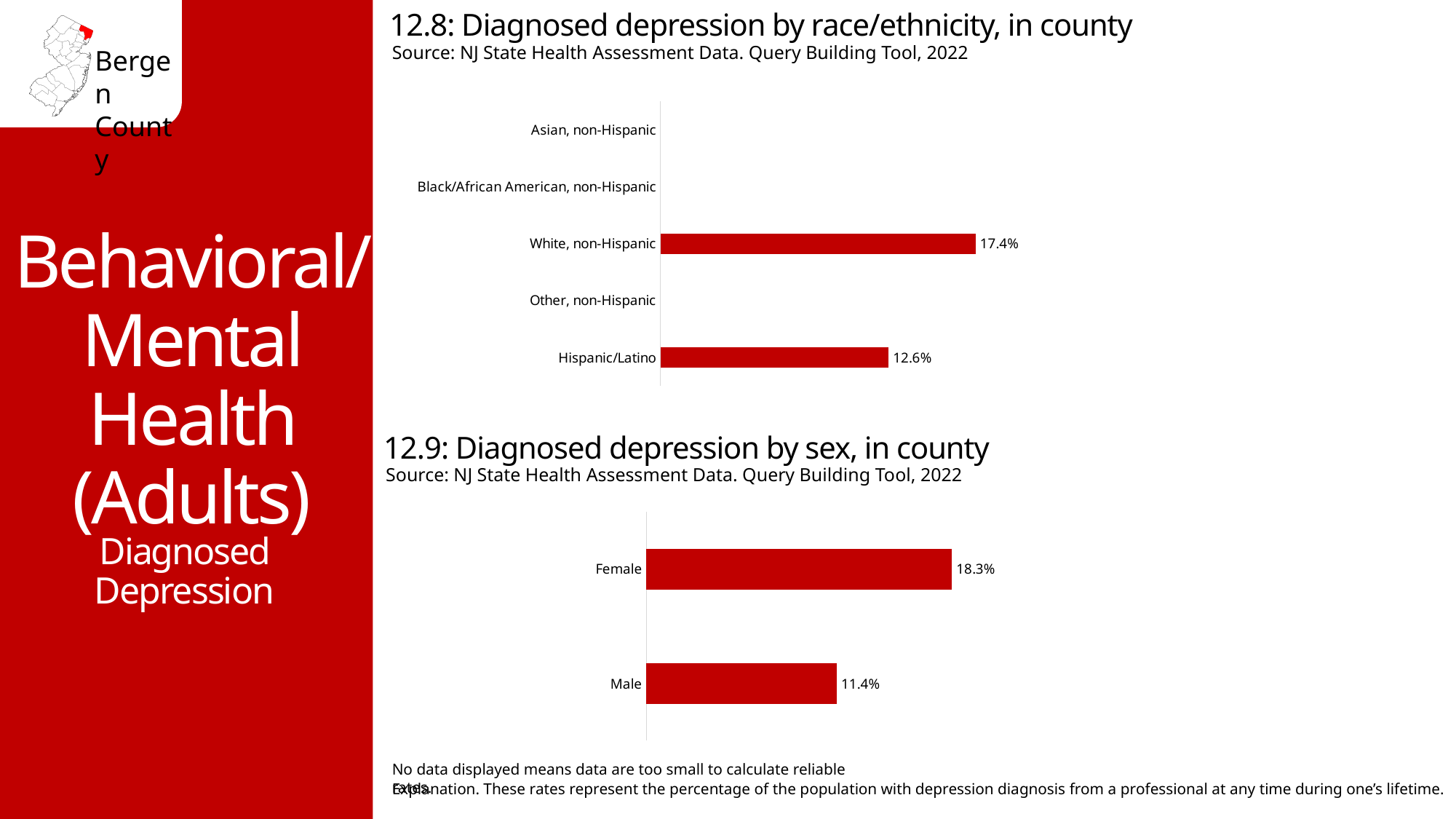
In the chart '12.9: Diagnosed depression by sex, in county', what is the value for Male? 11.4% In the chart '12.9: Diagnosed depression by sex, in county', is the value for Female larger than the value for Male? Yes In the chart '12.8: Diagnosed depression by race/ethnicity, in county', which category has the highest value? White, non-Hispanic In the chart '12.8: Diagnosed depression by race/ethnicity, in county', how many categories have a bar displayed? 2 In the chart '12.8: Diagnosed depression by race/ethnicity, in county', what is the value for Hispanic/Latino? 12.6% What kind of chart is '12.8: Diagnosed depression by race/ethnicity, in county'? Bar chart In the chart '12.8: Diagnosed depression by race/ethnicity, in county', what is the value for White, non-Hispanic? 17.4% In the chart '12.8: Diagnosed depression by race/ethnicity, in county', what is the difference between the White, non-Hispanic and Hispanic/Latino values? 4.8% In the chart '12.8: Diagnosed depression by race/ethnicity, in county', how many categories are listed on the axis? 5 In the chart '12.9: Diagnosed depression by sex, in county', which category has the lower value? Male In the chart '12.9: Diagnosed depression by sex, in county', what is the difference between the Female and Male values? 6.9% In the chart '12.9: Diagnosed depression by sex, in county', what is the value for Female? 18.3%